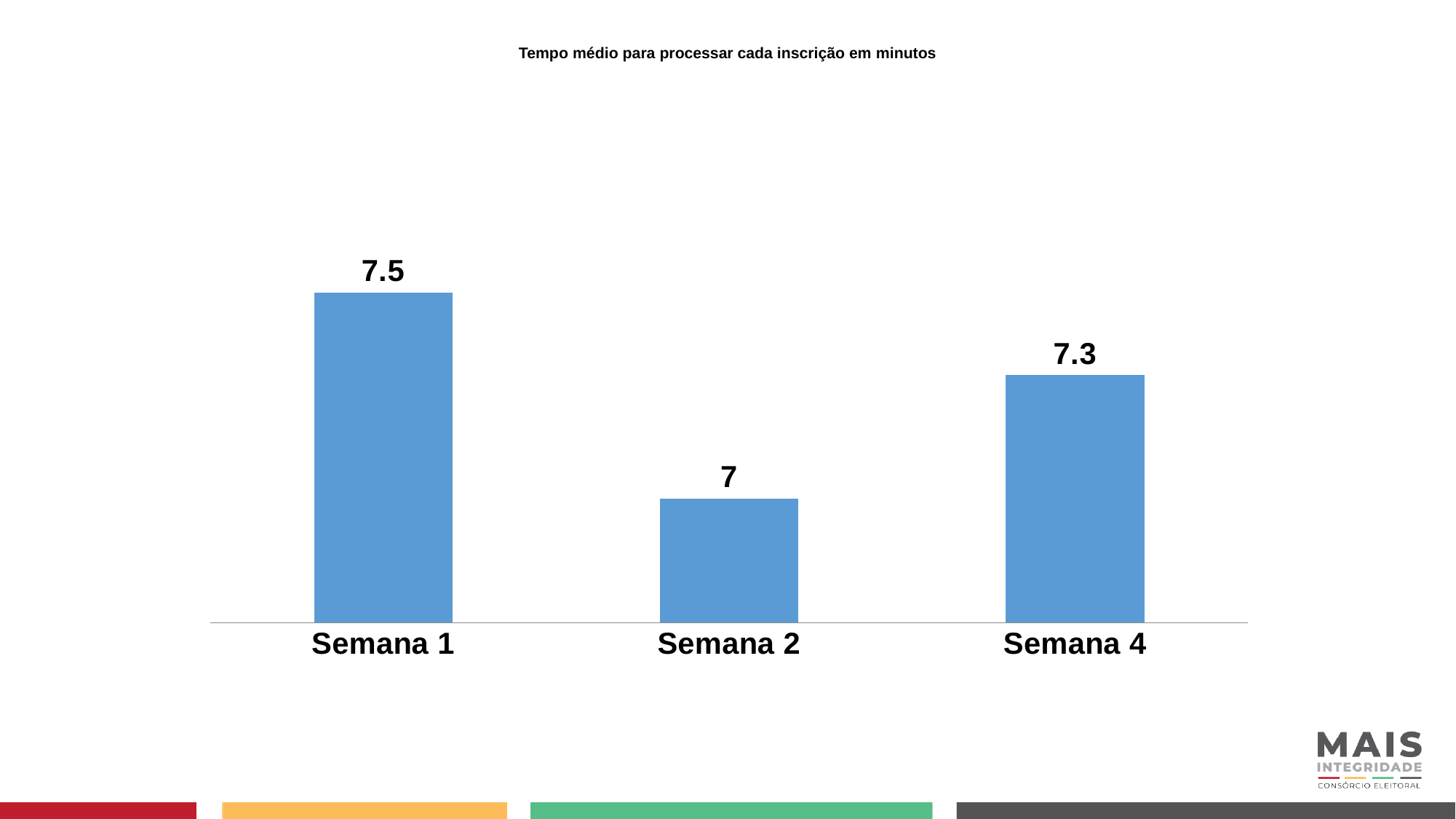
What kind of chart is shown on the slide? Bar chart Which category has the highest value? Semana 1 What is the value for Semana 2? 7 Which category has the lowest value? Semana 2 What is the value for Semana 4? 7.3 Which is larger, the value for Semana 1 or the value for Semana 4? Semana 1 What is the difference between the values for Semana 1 and Semana 2? 0.5 What is the difference between the values for Semana 4 and Semana 2? 0.3 How many categories are shown on the x axis? 3 What colour are the bars in the chart? Blue What is the title of the chart? Tempo médio para processar cada inscrição em minutos What is the value for Semana 1? 7.5